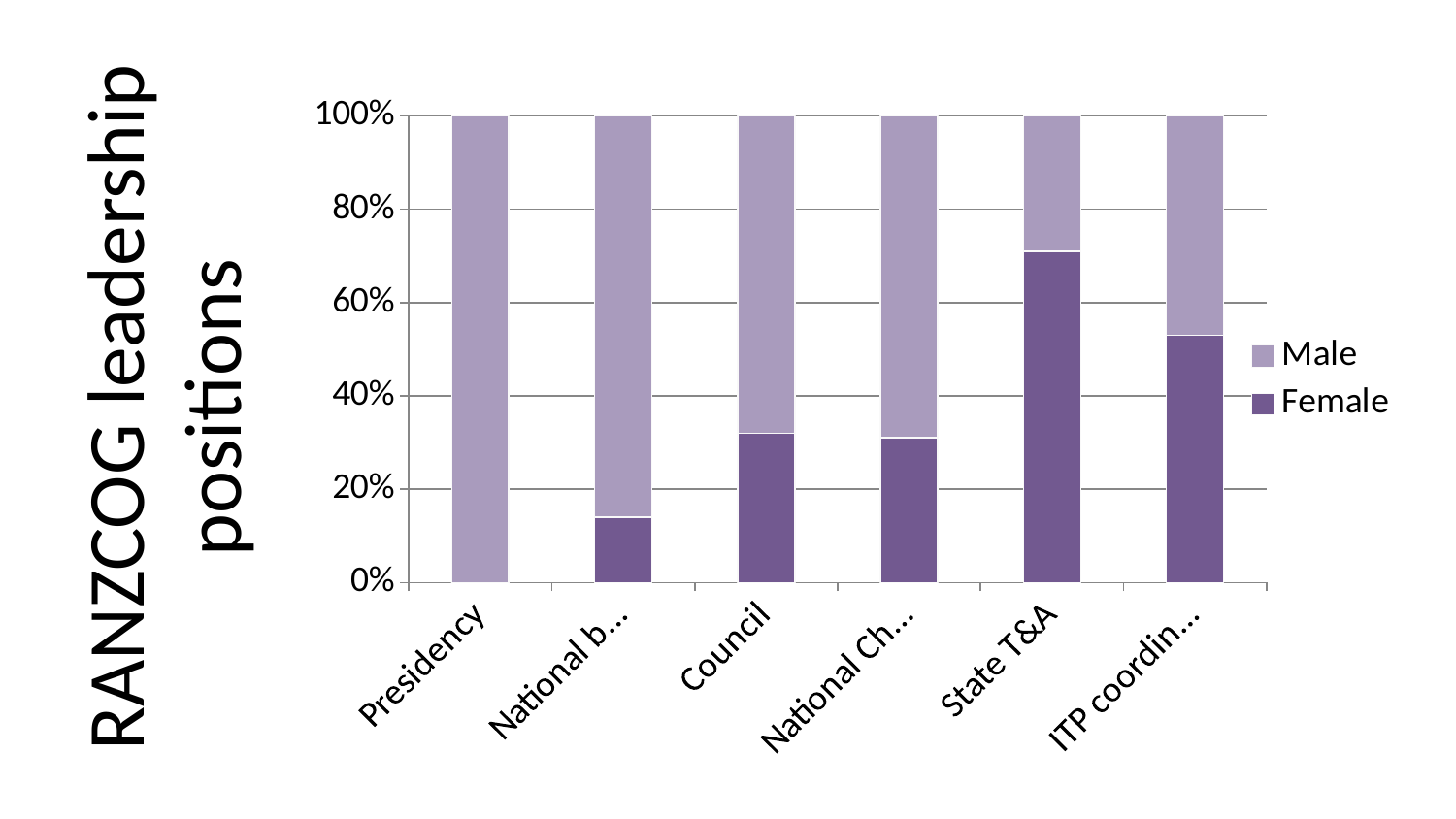
How many categories are shown along the x axis? 6 Is the Female share for State T&A larger than the Female share for Council? Yes, State T&A Which series is shown in the darker purple colour? Female How many series does the legend list? 2 Is the Female share for Council greater or less than 40%? less Is the Female share for Council greater or less than 20%? greater What is the Male share for Presidency? 100% What kind of chart is shown on the slide? Stacked bar chart Is the Female share for State T&A greater or less than 60%? greater What is the title of the chart? RANZCOG leadership positions Which category has the lowest Female share? Presidency Which category has the highest Female share? State T&A